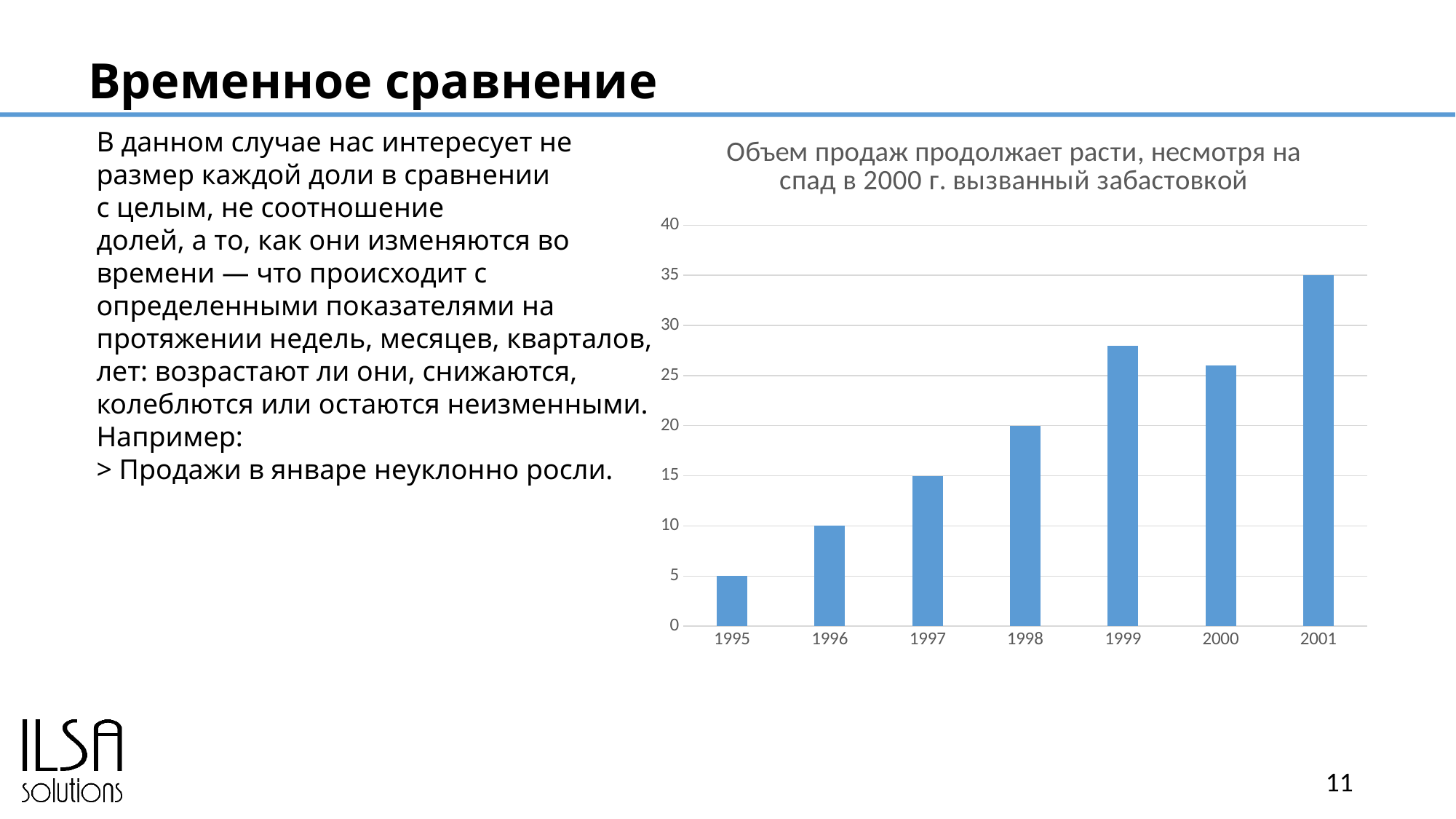
Which year has the larger value, 1999 or 2000? 1999 What is the value for 1997? 15 Is the value for 1999 greater or less than 25? greater Which year has the lowest value? 1995 What kind of chart is shown on the slide? bar chart What is the value for 2001? 35 Is the value for 2000 greater or less than 30? less Which year has the highest value? 2001 What is the value for 1995? 5 What is the title of the chart? Объем продаж продолжает расти, несмотря на спад в 2000 г. вызванный забастовкой What is the difference between the values for 2001 and 1995? 30 How many years are shown on the x axis of the chart? 7